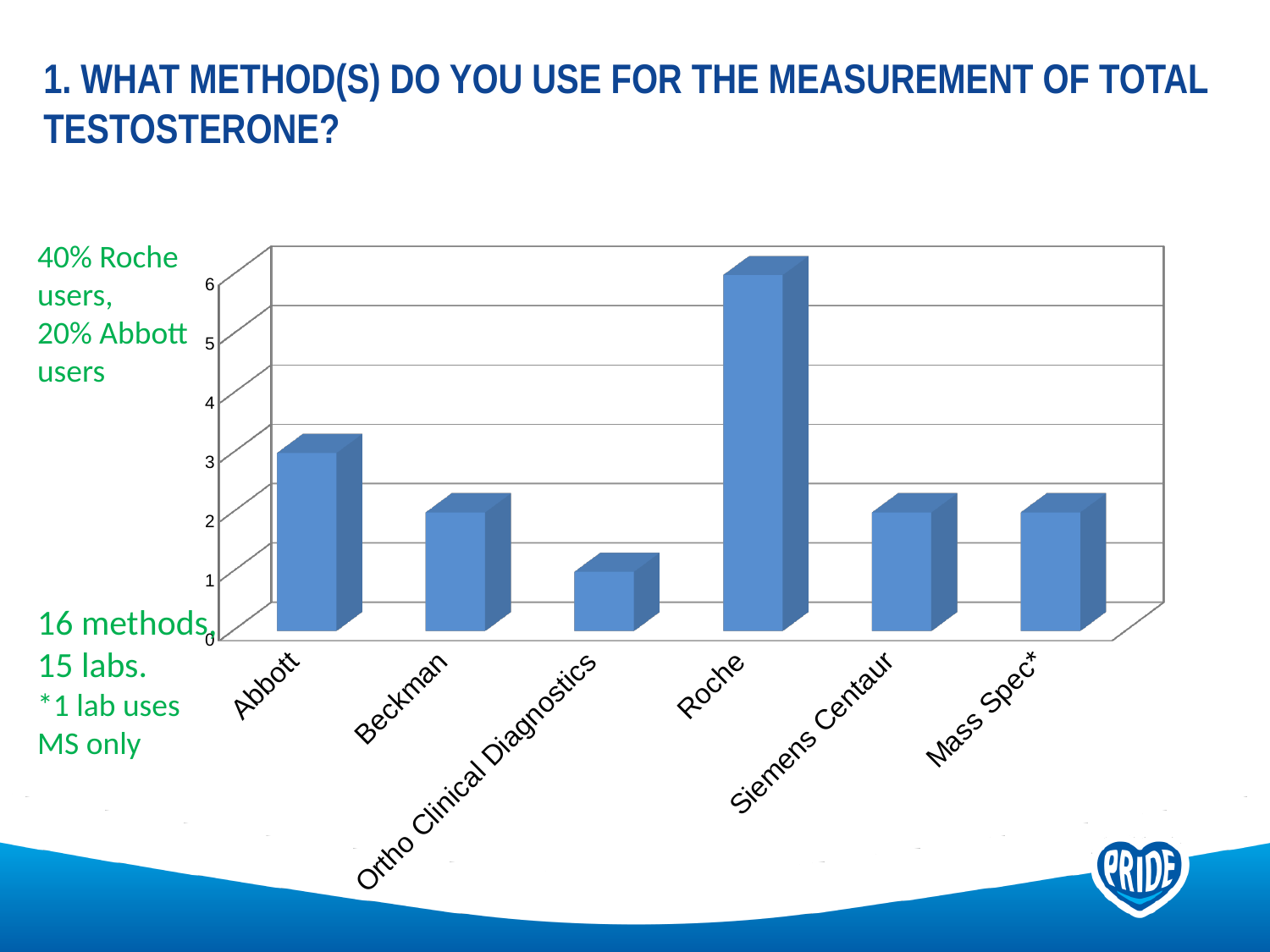
Is the value for Beckman greater or less than 3? less What is the difference between the value for Roche and the value for Abbott? 3 What is the value for Roche in the chart? 6 How many categories (methods) are shown on the x axis of the chart? 6 Which method has the highest bar in the chart? Roche What is the value for Ortho Clinical Diagnostics in the chart? 1 Which method has the lowest bar in the chart? Ortho Clinical Diagnostics What is the value for Abbott in the chart? 3 What type of chart is shown on the slide? bar chart According to the green text on the slide, what percentage of users are Roche users? 40% Which is larger, the value for Abbott or the value for Siemens Centaur? Abbott Is the value for Roche greater or less than 5? greater